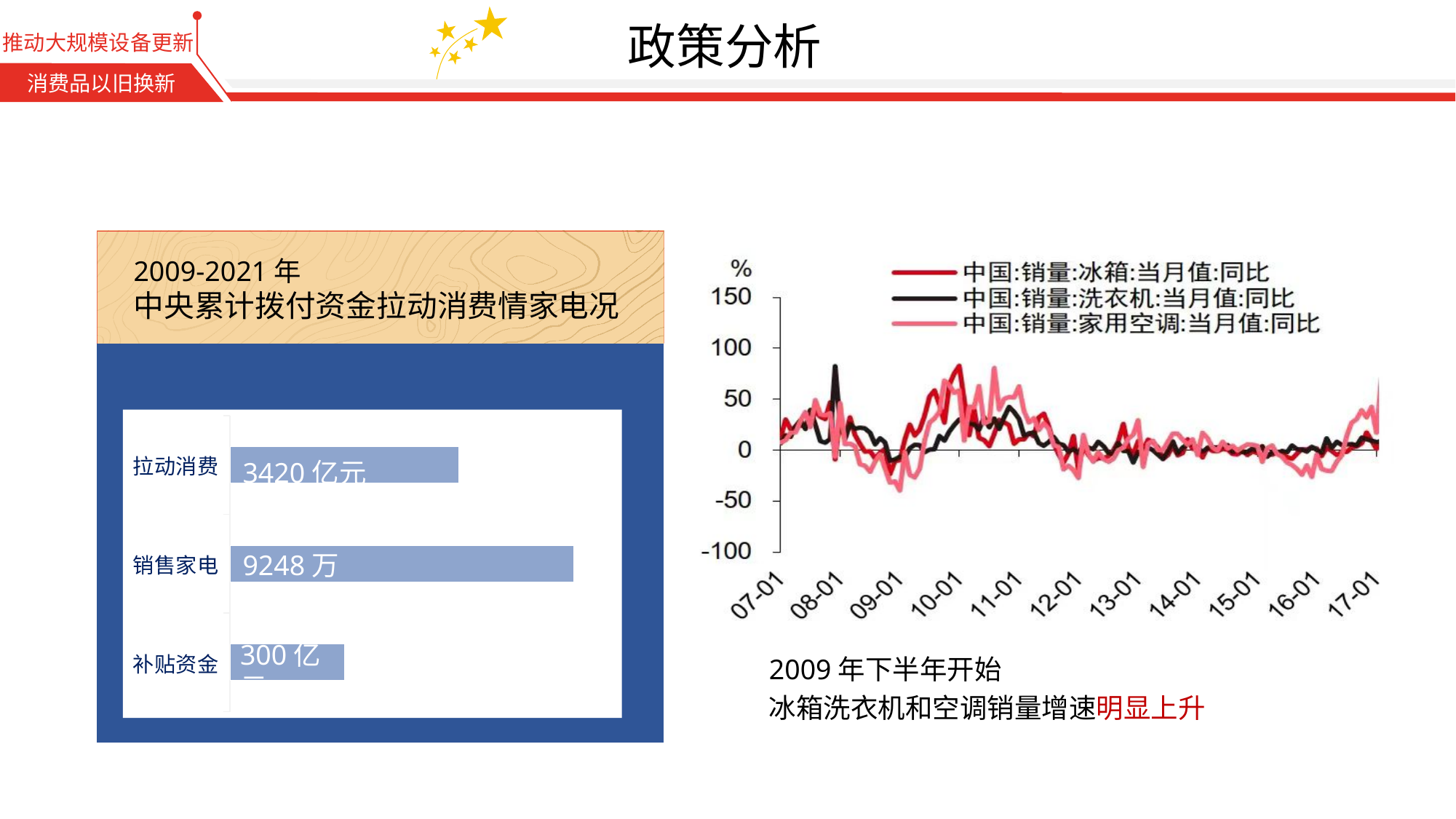
On the left chart, how many categories are shown? 3 What kind of chart is the left chart? bar chart On the left chart, what is the value for 补贴资金? 300 亿元 On the left chart, what is the value for 销售家电? 9248 万 On the left chart (2009-2021 年 中央累计拨付资金拉动消费情家电况), what is the value for 拉动消费? 3420 亿元 On the right chart, which series is drawn in black? 中国:销量:洗衣机:当月值:同比 On the right chart, how many year labels are shown on the x axis? 11 On the right chart, is the peak of the 洗衣机 (black) line near 08-01 greater or less than 50? greater What kind of chart is the right chart? line chart On the left chart, which category has the shortest bar? 补贴资金 On the right chart, how many series does the legend list? 3 On the left chart, which category has the longest bar? 销售家电